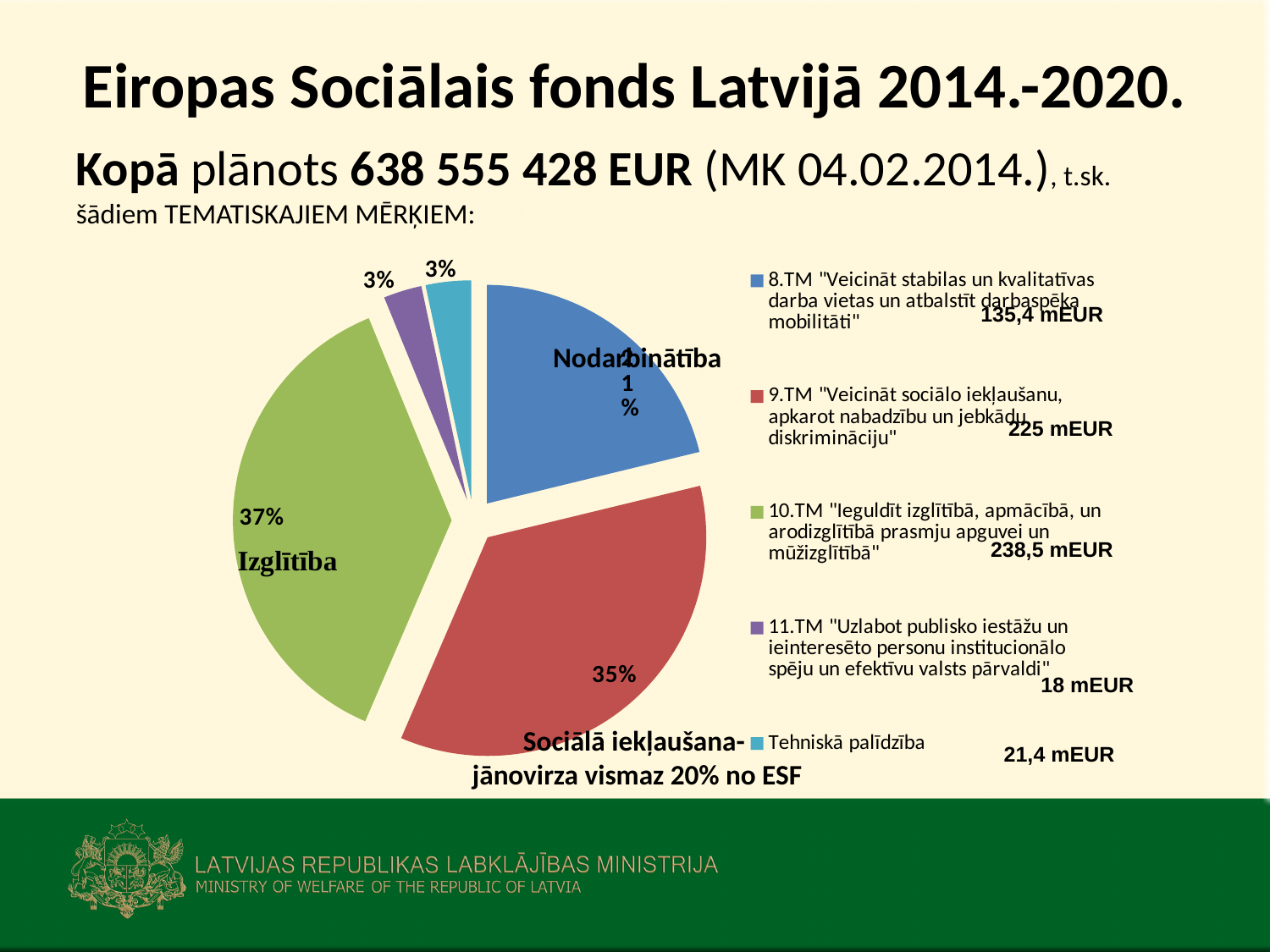
How many slices does the pie chart have? 5 Which thematic objective has the largest slice of the pie? 10.TM What share of the pie does 10.TM (Izglītība) have? 37% What is the difference in percentage points between the 10.TM slice and the 9.TM slice? 2% What kind of chart is shown on the slide? pie chart How many entries does the legend list? 5 What share of the pie does Tehniskā palīdzība have? 3% What share of the pie does 9.TM (Sociālā iekļaušana) have? 35% What colour is the 10.TM slice? green What amount in mEUR is shown next to the 9.TM legend entry? 225 mEUR Which slice is larger, 10.TM or 9.TM? 10.TM